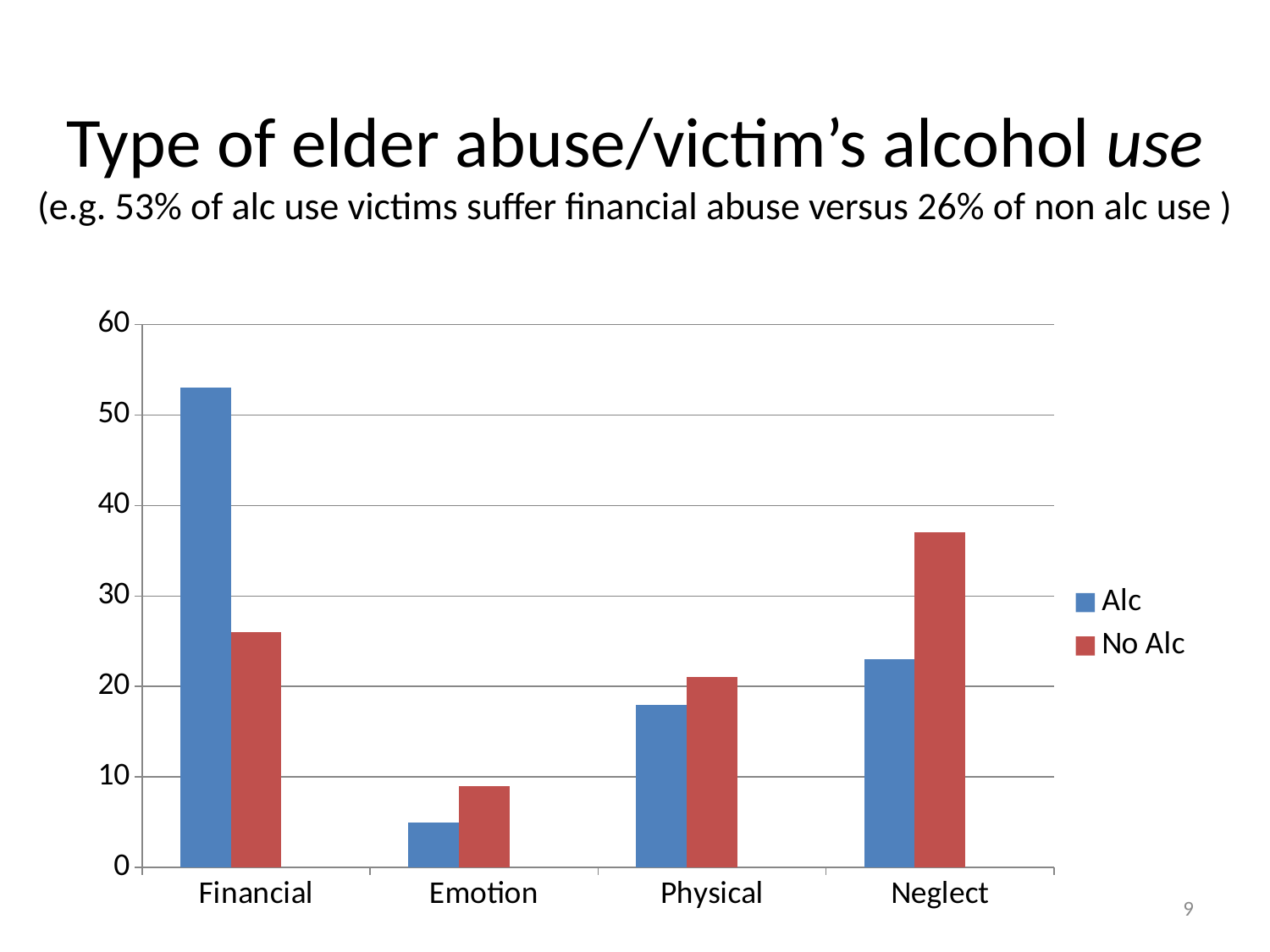
How many abuse-type categories are shown on the x axis? 4 For Neglect, which series has the larger value, Alc or No Alc? No Alc What is the difference between the Alc and No Alc values for Financial abuse? 27 For which category is the No Alc series highest? Neglect What are the two series named in the legend? Alc and No Alc Is the No Alc value for Neglect greater or less than 30? greater What type of chart is shown on the slide? Bar chart How many series does the legend list? 2 According to the slide, what percentage of alcohol-use victims suffer financial abuse? 53% For which category is the Alc series highest? Financial For which category is the Alc series lowest? Emotion According to the slide, what percentage of non-alcohol-use victims suffer financial abuse? 26%